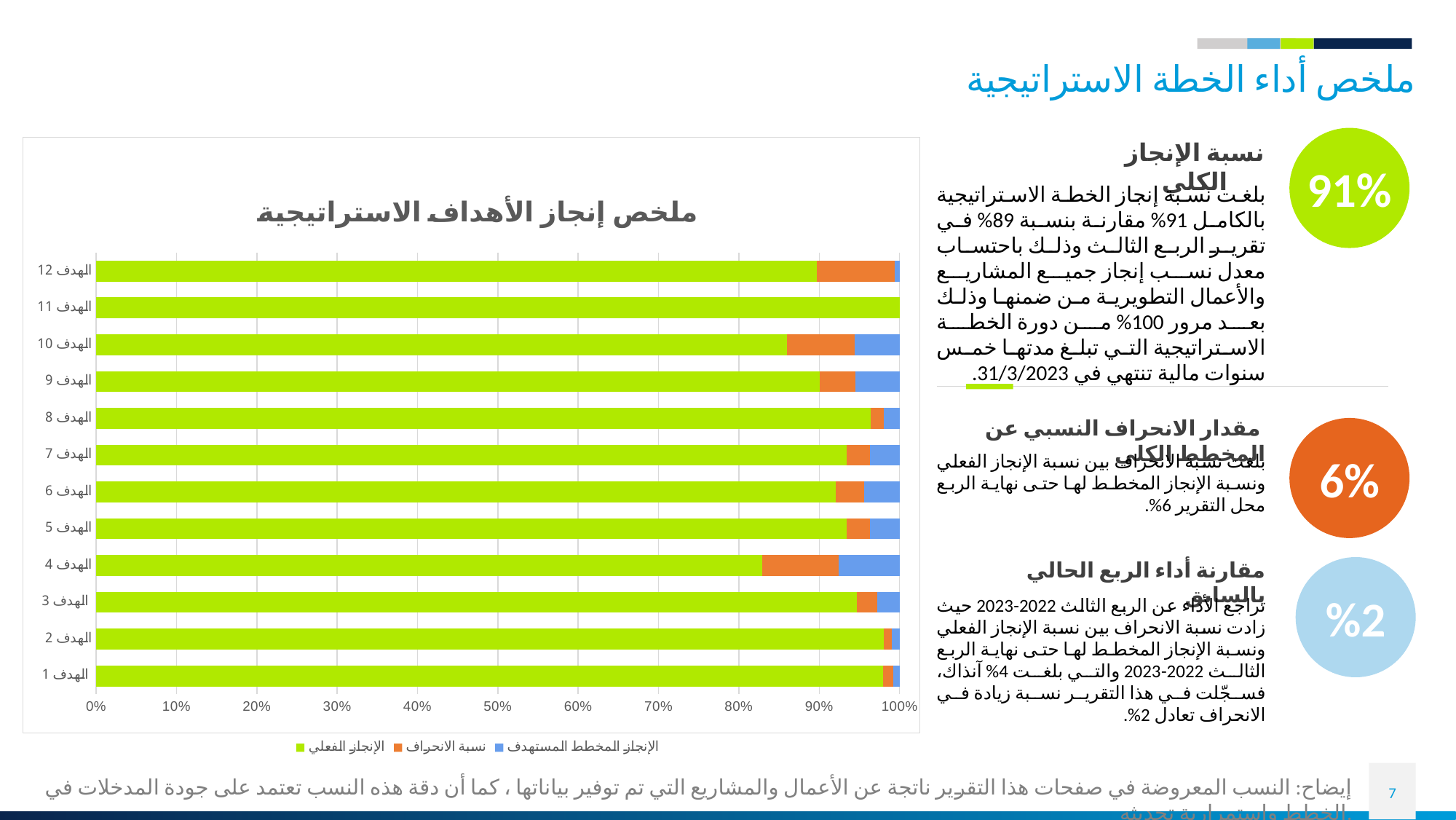
Which has a larger value for الإنجاز الفعلي, الهدف 4 or الهدف 11? الهدف 11 How many categories (objectives) are plotted on the chart? 12 How many series does the chart legend list? 3 What is the title of the chart on the slide? ملخص إنجاز الأهداف الاستراتيجية Is the value of الإنجاز الفعلي for الهدف 1 greater or less than 90%? greater Which objective has the lowest value for الإنجاز الفعلي? الهدف 4 Which objective has the highest value for الإنجاز الفعلي? الهدف 11 What kind of chart is shown on the slide? Stacked bar chart Which has a larger value for الإنجاز الفعلي, الهدف 10 or الهدف 2? الهدف 2 Is the value of الإنجاز الفعلي for الهدف 4 greater or less than 90%? less Which colour represents the series الإنجاز الفعلي in the chart? Green Is the value of الإنجاز الفعلي for الهدف 10 greater or less than 90%? less